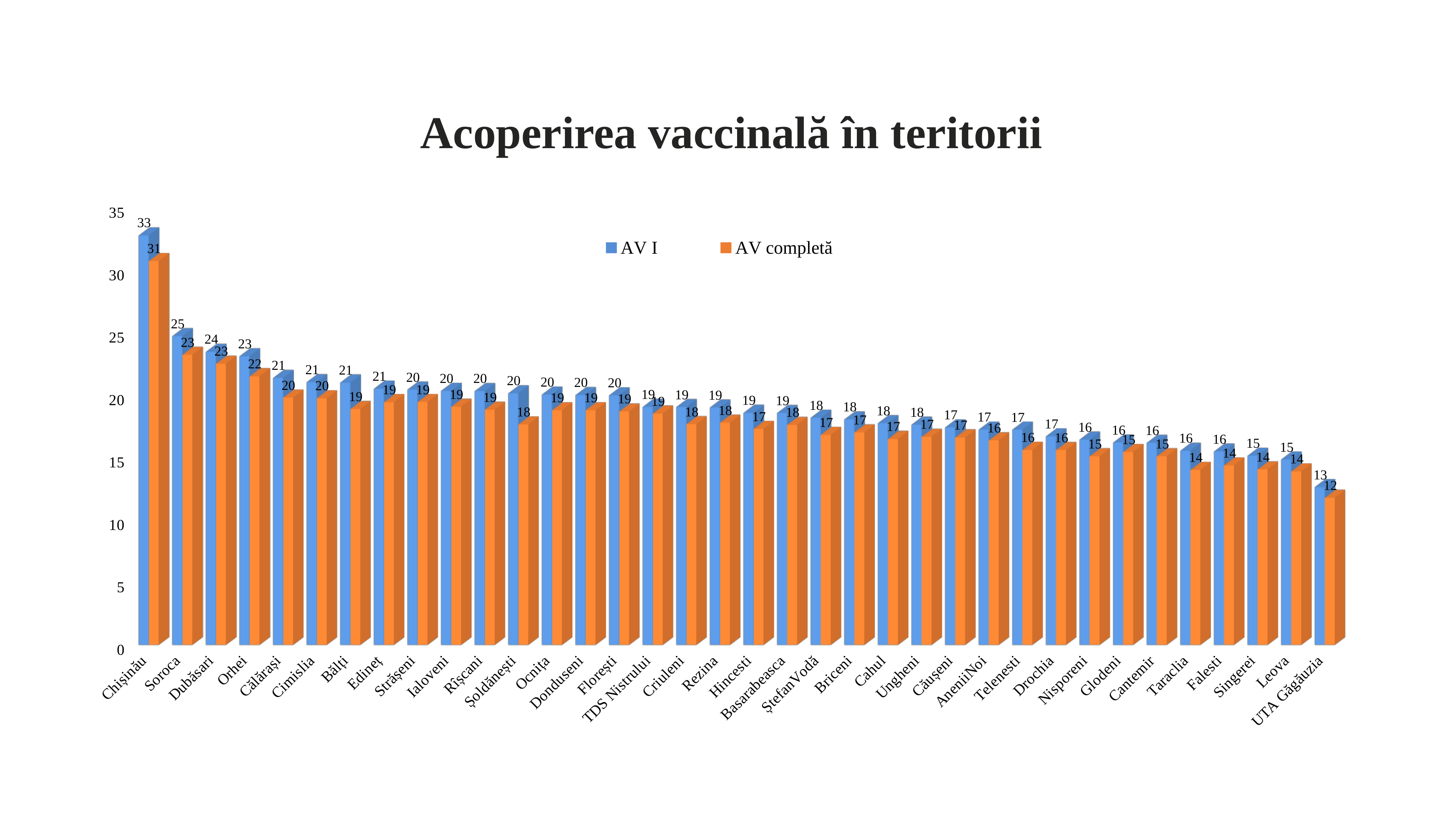
Which is larger, the AV I value for Dubăsari or the AV I value for Leova? Dubăsari What is the difference between the AV I and AV completă values for Chișinău? 2 How many series does the legend list? 2 How many territories are shown on the x axis? 36 What is the difference between the AV I values for Soroca and Orhei? 2 What is the AV completă value for Soroca? 23 Is the AV completă value for Chișinău greater or less than 30? greater What kind of chart is shown on the slide? bar chart Which territory has the highest AV I value? Chișinău Which territory has the lowest AV completă value? UTA Găgăuzia What is the AV completă value for UTA Găgăuzia? 12 What is the AV I value for Chișinău? 33